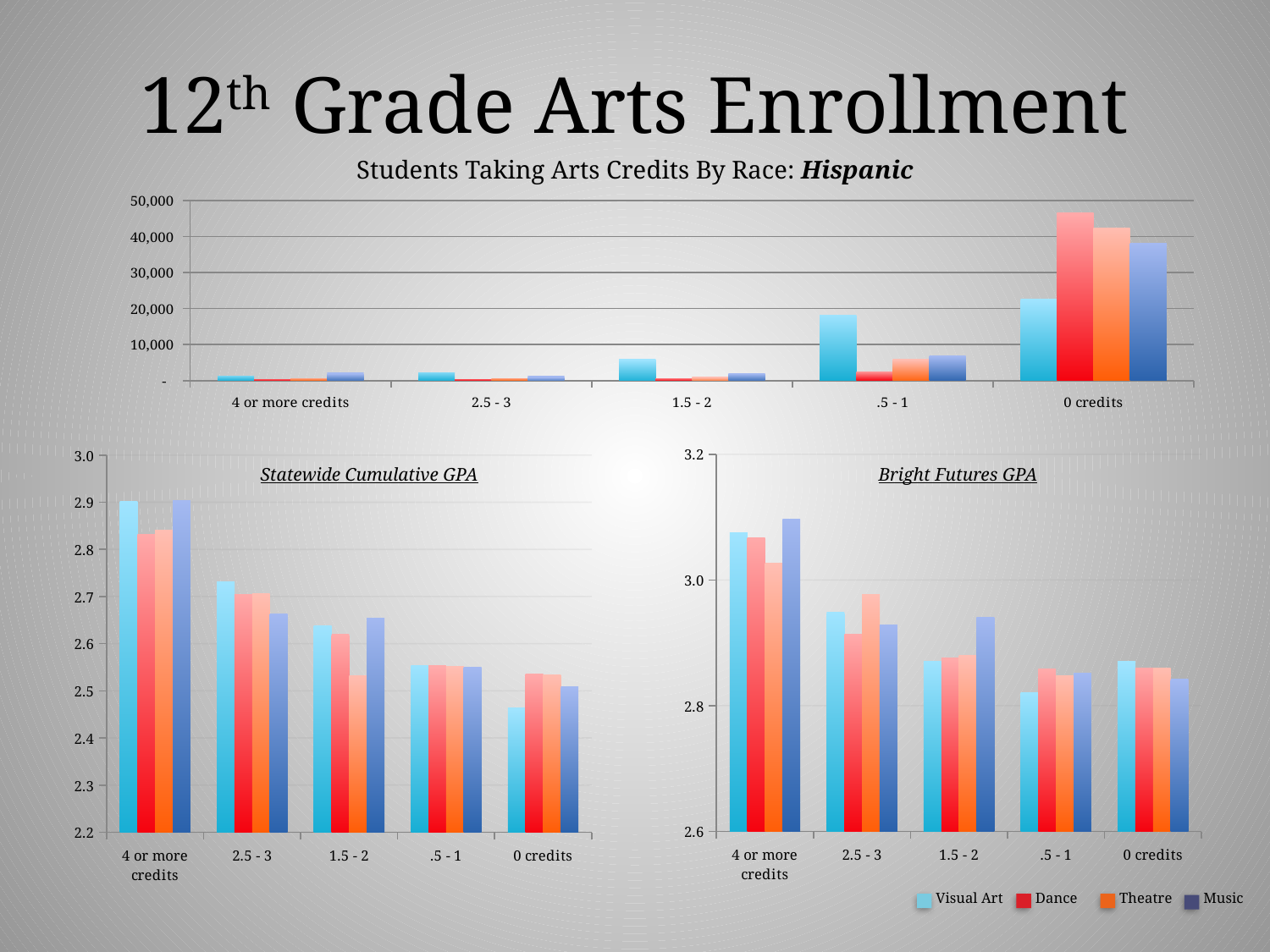
What kind of chart is the Statewide Cumulative GPA chart? bar chart How many series does the legend list? 4 In the top chart (Students Taking Arts Credits By Race: Hispanic), is the value for Dance at 0 credits greater or less than 40,000? greater In the top chart (Students Taking Arts Credits By Race: Hispanic), which credit category has the highest bars? 0 credits In the Statewide Cumulative GPA chart, is the value for Visual Art at 0 credits greater or less than 2.5? less In the Statewide Cumulative GPA chart, do the Visual Art values rise or fall from 4 or more credits to 0 credits? fall In the top chart (Students Taking Arts Credits By Race: Hispanic), which series has the tallest bar at 0 credits? Dance In the top chart (Students Taking Arts Credits By Race: Hispanic), is the value for Visual Art at .5 - 1 credits greater or less than 20,000? less In the top chart (Students Taking Arts Credits By Race: Hispanic), is the Visual Art bar at .5 - 1 larger or smaller than the Dance bar at .5 - 1? larger In the Bright Futures GPA chart, which credit category has the highest GPA values? 4 or more credits How many credit categories are shown on the x axis of the Statewide Cumulative GPA chart? 5